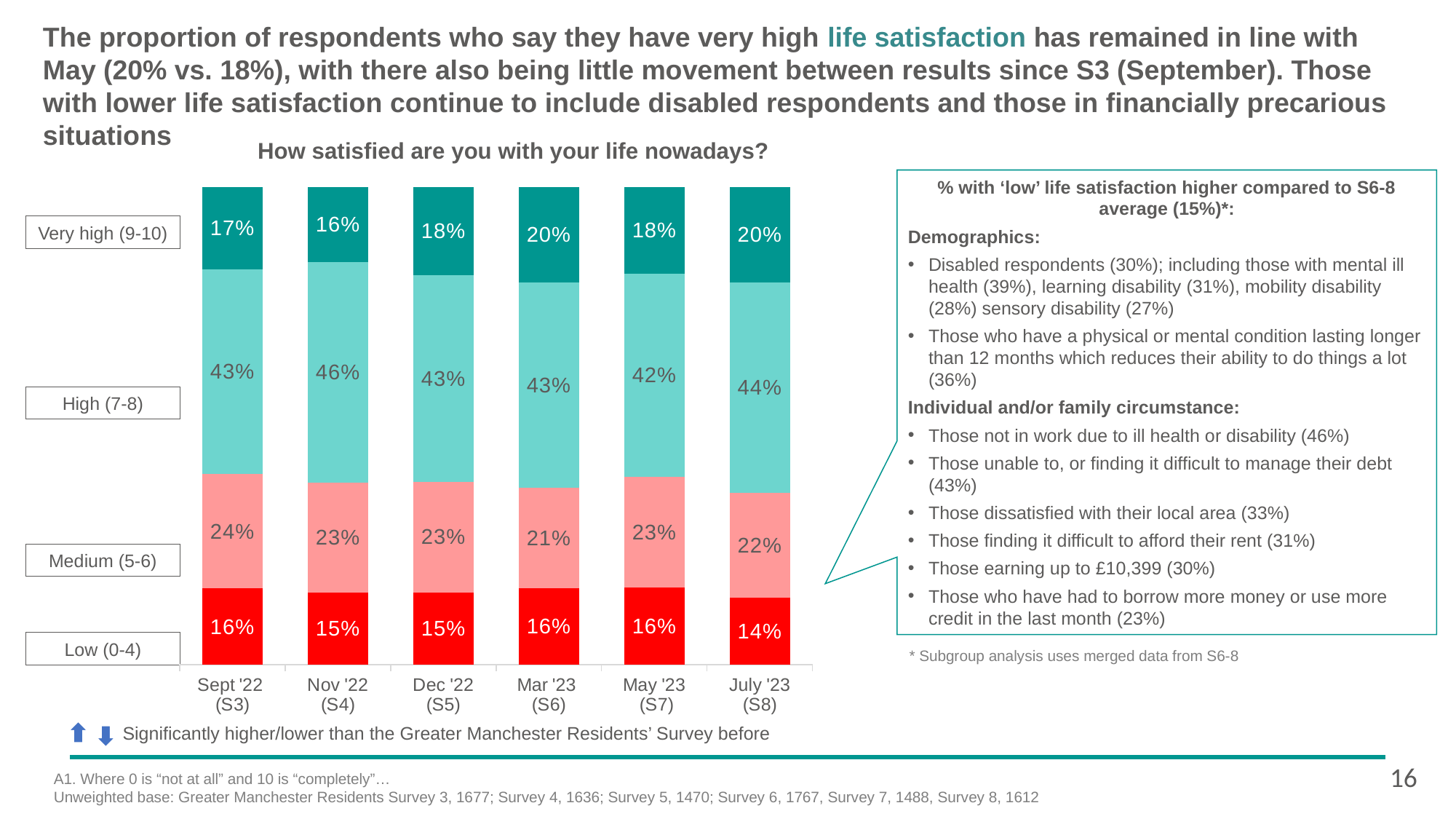
What type of chart is used to show the life satisfaction results? Stacked bar chart What percentage of respondents reported low (0-4) life satisfaction in Sept '22 (S3)? 16% What percentage of respondents reported very high (9-10) life satisfaction in July '23 (S8)? 20% What is the difference in the very high (9-10) share between May '23 (S7) and July '23 (S8)? 2 percentage points How many satisfaction categories are stacked in each bar? 4 What percentage of respondents reported medium (5-6) life satisfaction in Mar '23 (S6)? 21% Which is larger: the high (7-8) share in Dec '22 (S5) or in July '23 (S8)? July '23 (S8) What percentage of respondents reported high (7-8) life satisfaction in Nov '22 (S4)? 46% How many survey waves are shown on the x axis of the chart? 6 In which survey wave was the low (0-4) life satisfaction share the lowest? July '23 (S8) In which survey wave was the medium (5-6) life satisfaction share the highest? Sept '22 (S3) What is the title of the chart? How satisfied are you with your life nowadays?